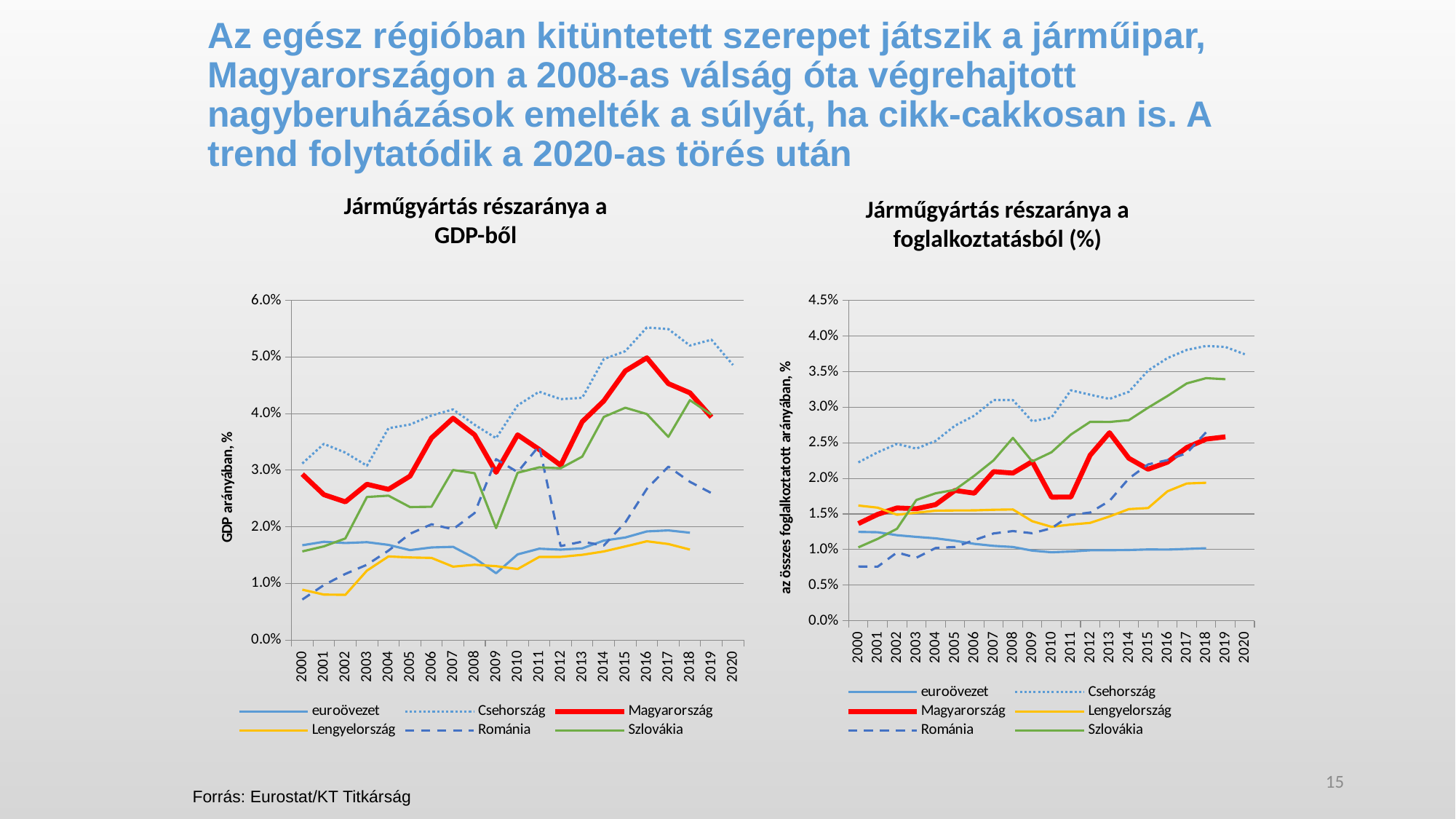
In the right chart, 'Járműgyártás részaránya a foglalkoztatásból (%)', which is larger in 2019: Csehország or Magyarország? Csehország How many series does the legend of the right chart, 'Járműgyártás részaránya a foglalkoztatásból (%)', list? 6 In the left chart, 'Járműgyártás részaránya a GDP-ből', which series has the highest value in 2016? Csehország In the left chart, 'Járműgyártás részaránya a GDP-ből', is the value for Magyarország in 2002 greater or less than 3.0%? less What is the y-axis label of the left chart, 'Járműgyártás részaránya a GDP-ből'? GDP arányában, % What kind of chart is the left chart, 'Járműgyártás részaránya a GDP-ből'? line chart In the right chart, 'Járműgyártás részaránya a foglalkoztatásból (%)', which series has the lowest value in 2018? euroövezet In the left chart, 'Járműgyártás részaránya a GDP-ből', is the value for Csehország in 2016 greater or less than 5.0%? greater In the right chart, 'Járműgyártás részaránya a foglalkoztatásból (%)', does the Szlovákia line rise or fall from 2000 to 2019? rise In the right chart, 'Járműgyártás részaránya a foglalkoztatásból (%)', is the value for Csehország in 2018 greater or less than 3.5%? greater How many years are shown on the x axis of the left chart, 'Járműgyártás részaránya a GDP-ből'? 21